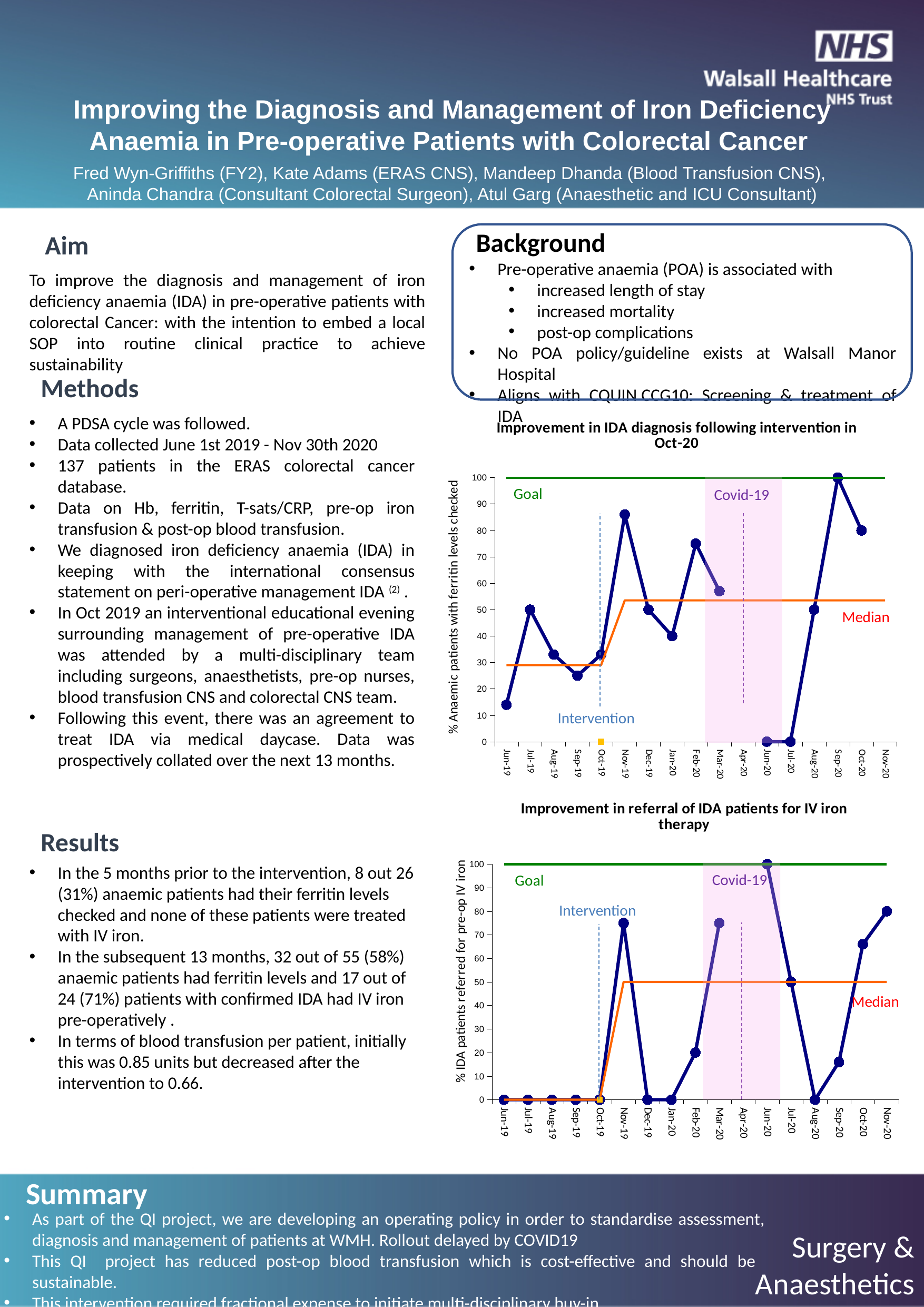
In the 'Improvement in IDA diagnosis following intervention in Oct-20' chart, which month has the highest percentage of anaemic patients with ferritin levels checked? Sep-20 In the 'Improvement in referral of IDA patients for IV iron therapy' chart, what does the pink shaded region represent? Covid-19 In the 'Improvement in IDA diagnosis following intervention in Oct-20' chart, what is the value for Jan-20? 40 In the 'Improvement in referral of IDA patients for IV iron therapy' chart, is the value for Oct-20 greater or less than 60? greater In the 'Improvement in referral of IDA patients for IV iron therapy' chart, what is the value for Jul-20? 50 What type of chart is the 'Improvement in IDA diagnosis following intervention in Oct-20' chart? Line chart In the 'Improvement in referral of IDA patients for IV iron therapy' chart, which month has the highest value? Jun-20 In the 'Improvement in IDA diagnosis following intervention in Oct-20' chart, which is higher, Feb-20 or Mar-20? Feb-20 In the 'Improvement in IDA diagnosis following intervention in Oct-20' chart, what is the value for Oct-20? 80 In the 'Improvement in IDA diagnosis following intervention in Oct-20' chart, is the value for Nov-19 greater or less than 80? greater In the 'Improvement in IDA diagnosis following intervention in Oct-20' chart, what is the difference between the values for Oct-20 and Aug-20? 30 In the 'Improvement in referral of IDA patients for IV iron therapy' chart, what is the value for Feb-20? 20